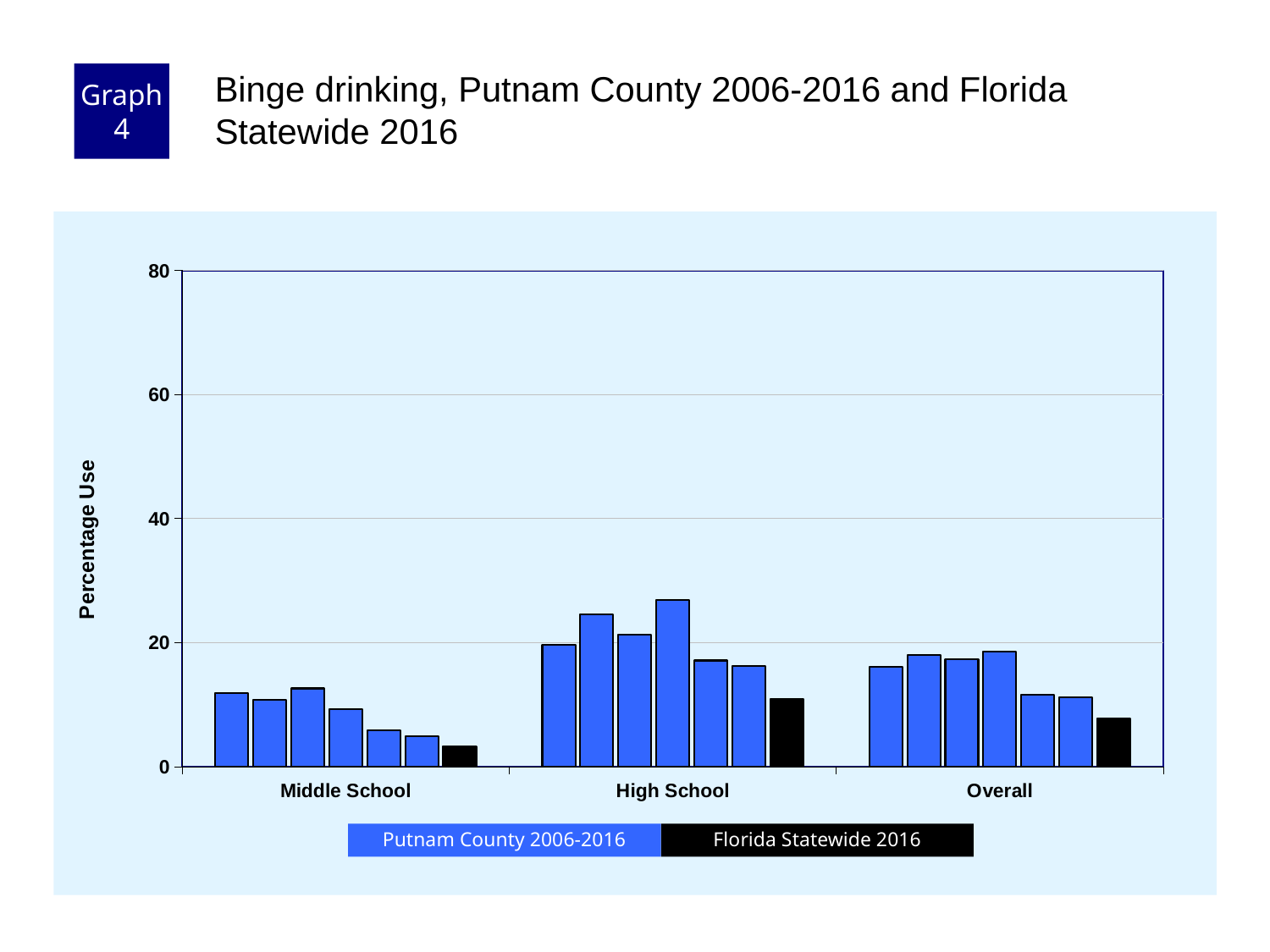
Is the Florida Statewide 2016 bar for Middle School greater or less than 20? less How many categories are shown on the x axis? 3 Is the Florida Statewide 2016 bar for High School greater or less than 20? less What is the label of the y axis? Percentage Use Is the tallest Putnam County 2006-2016 bar for High School greater or less than 20? greater How many series does the legend list? 2 What kind of chart is shown on the slide? bar chart Which category contains the shortest bar in the chart? Middle School Which colour represents Florida Statewide 2016 in the legend? black Which category contains the tallest bar in the chart? High School Which is larger, the Florida Statewide 2016 bar for High School or the Florida Statewide 2016 bar for Middle School? High School Which is larger, the Florida Statewide 2016 bar for Overall or the Florida Statewide 2016 bar for Middle School? Overall